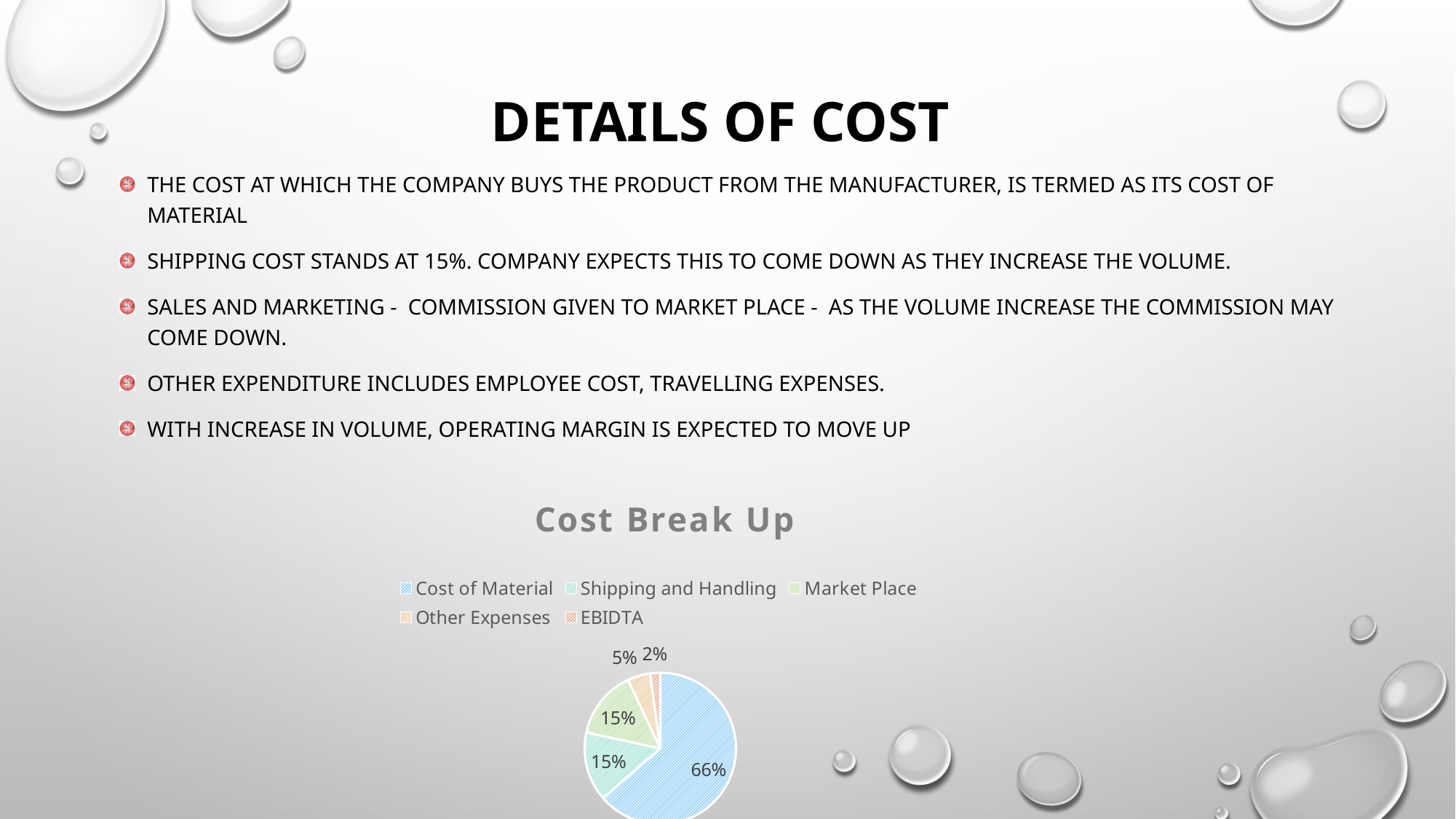
What percentage is shown for Other Expenses in the Cost Break Up chart? 5% In the Cost Break Up chart, which is larger: Other Expenses or EBIDTA? Other Expenses What kind of chart is shown under the title "Cost Break Up"? Pie chart What share of the Cost Break Up pie is Cost of Material? 66% Which category has the smallest slice in the Cost Break Up pie chart? EBIDTA Which category has the largest slice in the Cost Break Up pie chart? Cost of Material How many entries does the legend of the Cost Break Up chart list? 5 What percentage is shown for Shipping and Handling in the Cost Break Up chart? 15% How many slices does the Cost Break Up pie chart have? 5 In the Cost Break Up chart, what is the difference between the Cost of Material share and the Market Place share? 51% What percentage is shown for EBIDTA in the Cost Break Up chart? 2% What is the title of the chart on the slide? Cost Break Up